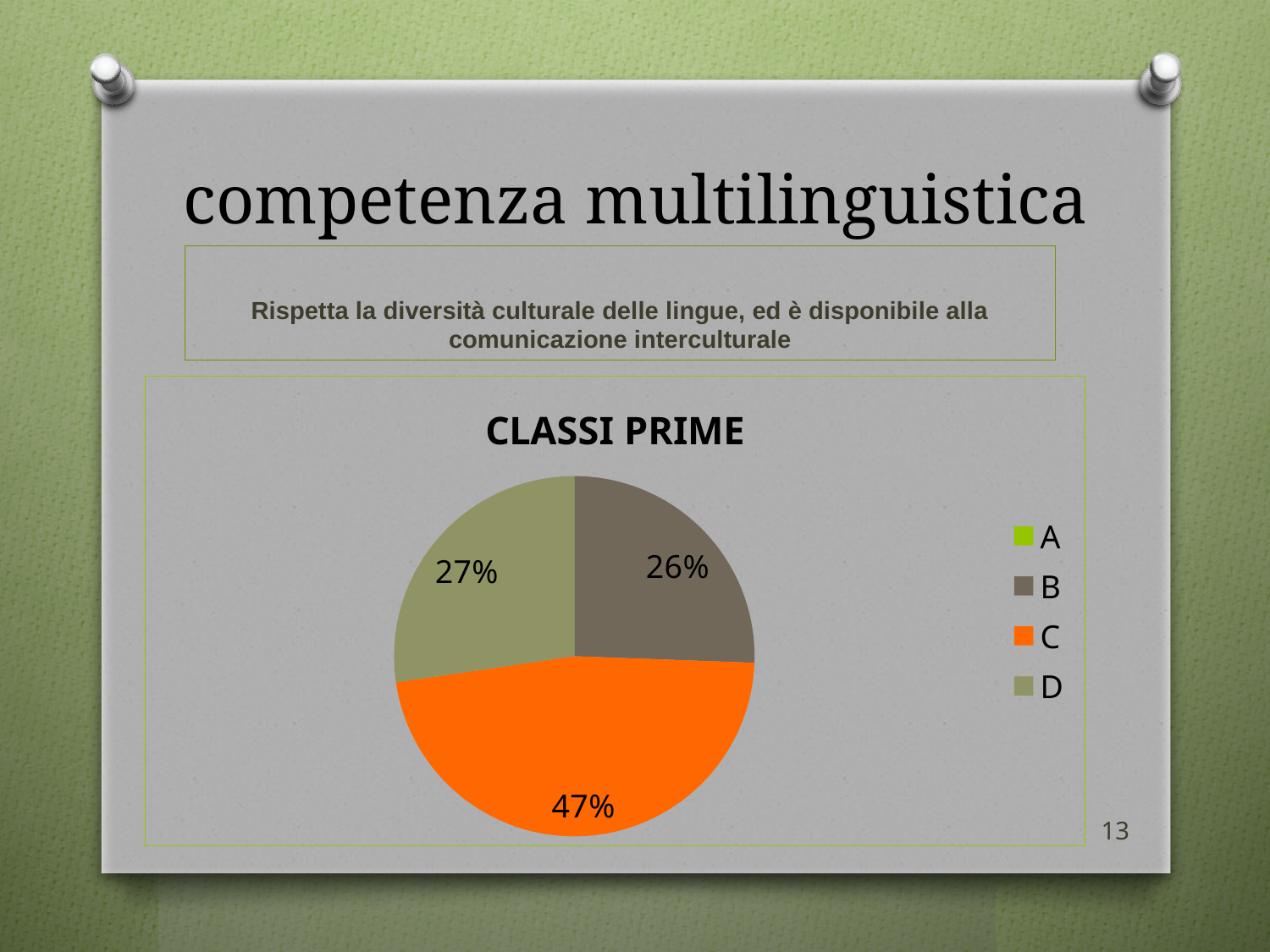
What percentage of the pie does slice C represent? 47% What is the difference in percentage points between slice C and slice B? 21 What percentage of the pie does slice B represent? 26% What is the title of the chart? CLASSI PRIME How many slices with percentage labels are visible in the pie? 3 What colour is slice C in the pie chart? orange What percentage of the pie does slice D represent? 27% Which of the labelled slices has the smallest share of the pie? B Which slice has the largest share of the pie? C Which is larger, the share for C or the share for D? C What kind of chart is shown on the slide? pie chart How many entries does the legend list? 4